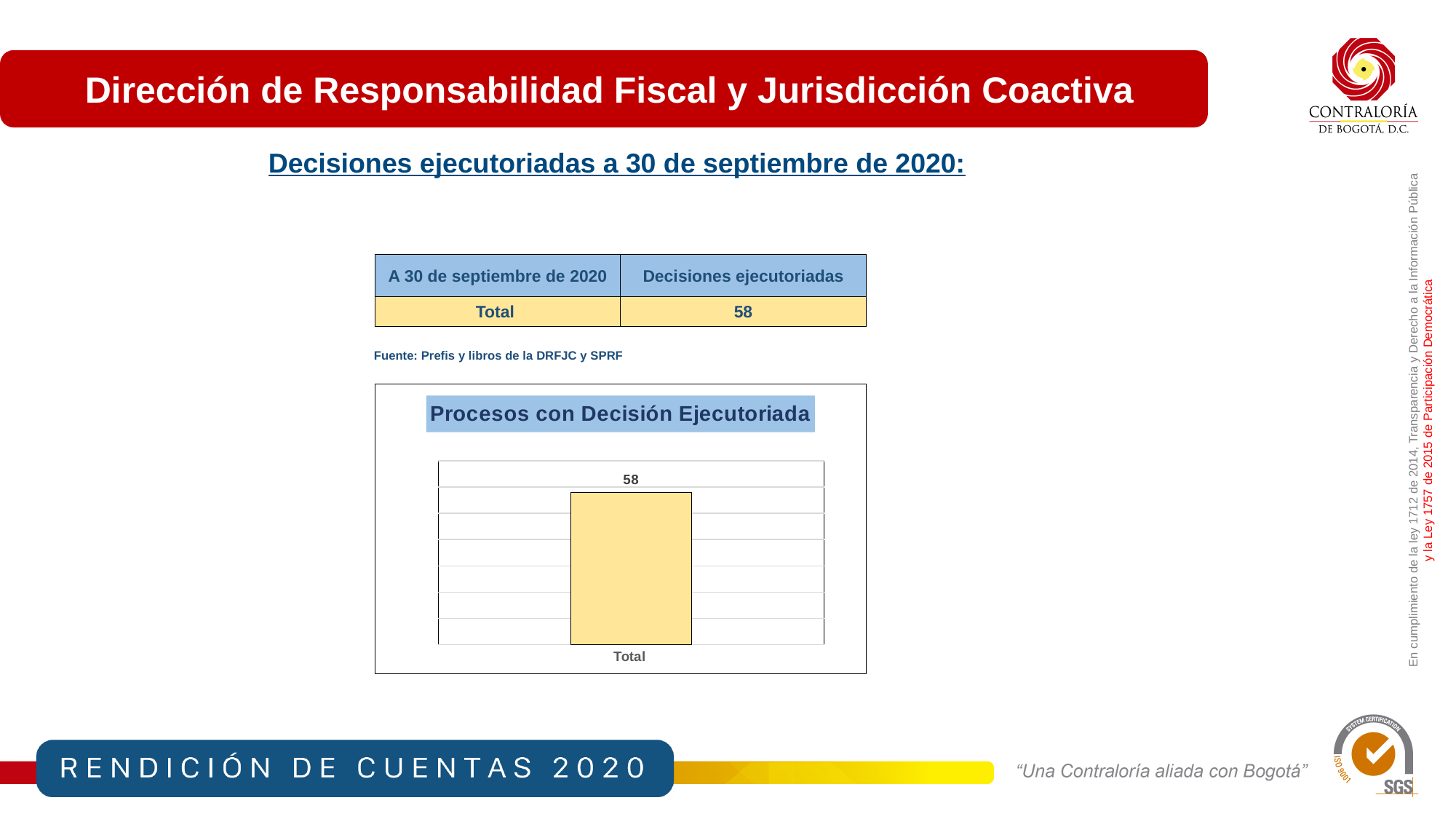
Is the value of the "Total" bar greater or less than 50? greater What is the value of the bar labelled "Total" in the chart? 58 What is the title of the chart? Procesos con Decisión Ejecutoriada What kind of chart is shown on the slide? bar chart How many bars does the chart contain? 1 What is the label of the category on the x axis of the chart? Total